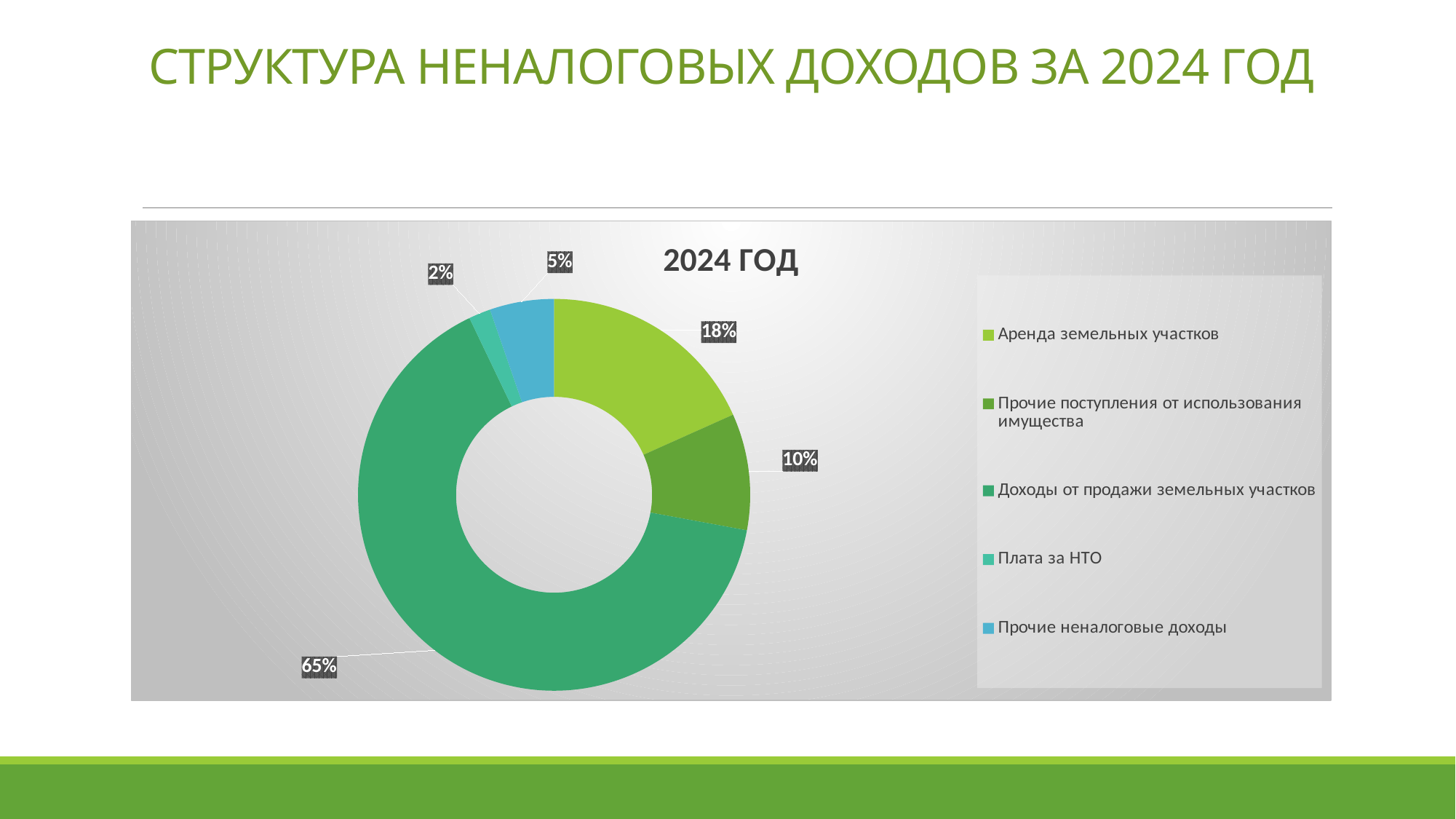
What share does Прочие поступления от использования имущества have in the chart? 10% What share does Аренда земельных участков have in the chart? 18% What is the difference in percentage points between Доходы от продажи земельных участков and Аренда земельных участков? 47 Which category has the largest share in the chart? Доходы от продажи земельных участков What is the title of the chart? 2024 ГОД What share does Доходы от продажи земельных участков have in the chart? 65% What kind of chart is shown on the slide? Doughnut chart Which category has the smallest share in the chart? Плата за НТО What share does Прочие неналоговые доходы have in the chart? 5% How many categories does the chart show? 5 Which is larger: the share for Прочие неналоговые доходы or the share for Прочие поступления от использования имущества? Прочие поступления от использования имущества What share does Плата за НТО have in the chart? 2%